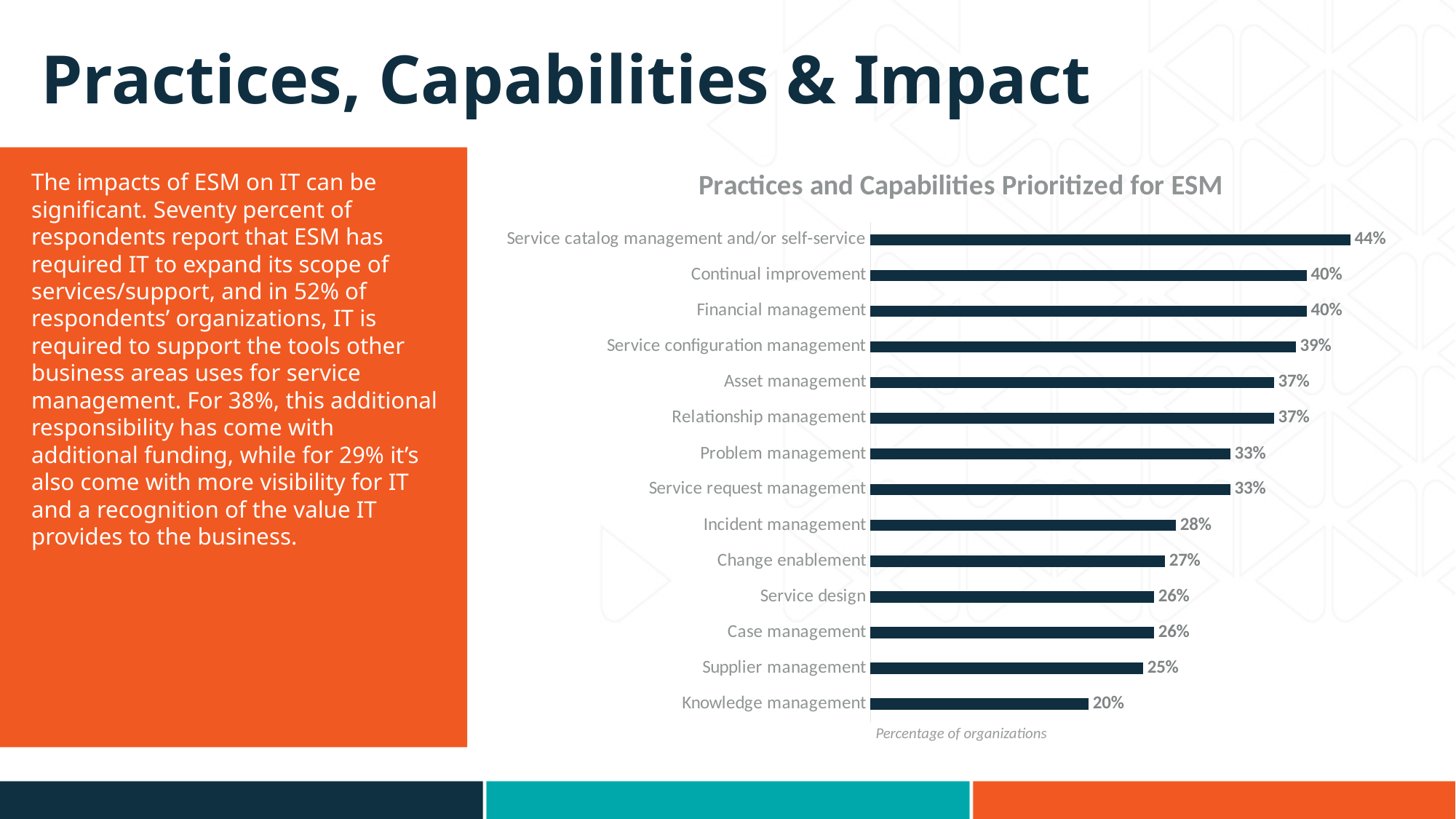
Which category has the lowest value? Knowledge management Which category has the highest value? Service catalog management and/or self-service What is the value for Supplier management? 25% What kind of chart is shown on the slide? Bar chart What is the axis label shown below the bars? Percentage of organizations What is the difference between the values for Service catalog management and/or self-service and Knowledge management? 24% What is the title of the chart? Practices and Capabilities Prioritized for ESM What is the value for Incident management? 28% What is the difference between the values for Continual improvement and Problem management? 7% Which is larger, the value for Asset management or the value for Change enablement? Asset management What is the value for Service catalog management and/or self-service? 44% How many categories are shown in the chart? 14